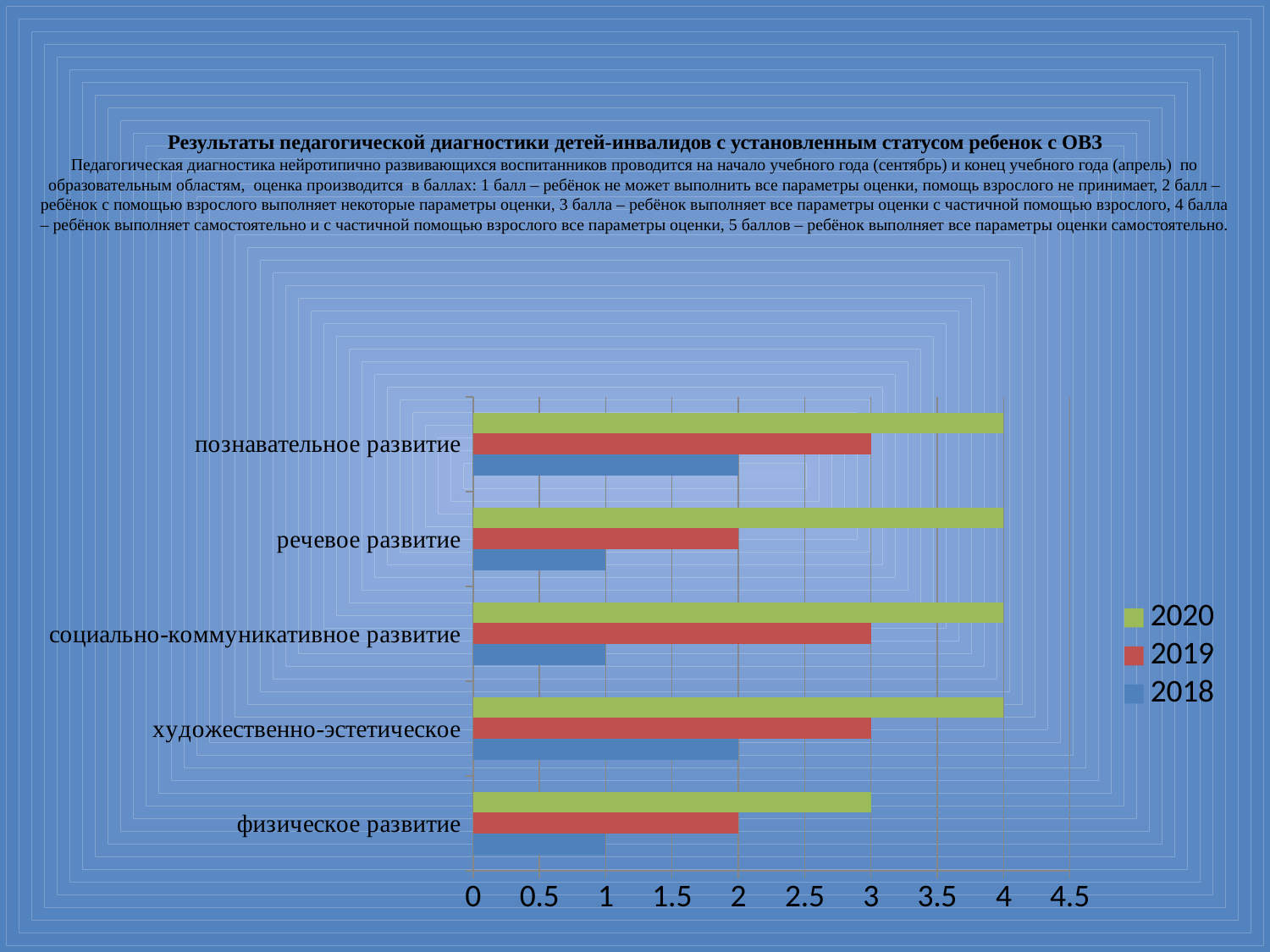
How many series does the legend list? 3 Which legend entry is shown in green? 2020 Is the 2020 value for "познавательное развитие" greater or less than 3.5? greater Which category has the lowest value for the 2020 series? физическое развитие What is the value for 2018 in the category "художественно-эстетическое"? 2 What is the value for 2020 in the category "физическое развитие"? 3 What kind of chart is shown on the slide? bar chart What is the value for 2019 in the category "познавательное развитие"? 3 How many categories are shown on the chart? 5 What is the value for 2018 in the category "речевое развитие"? 1 What is the difference between the 2020 and 2018 values for "социально-коммуникативное развитие"? 3 Which is larger for "речевое развитие": the 2019 value or the 2018 value? 2019